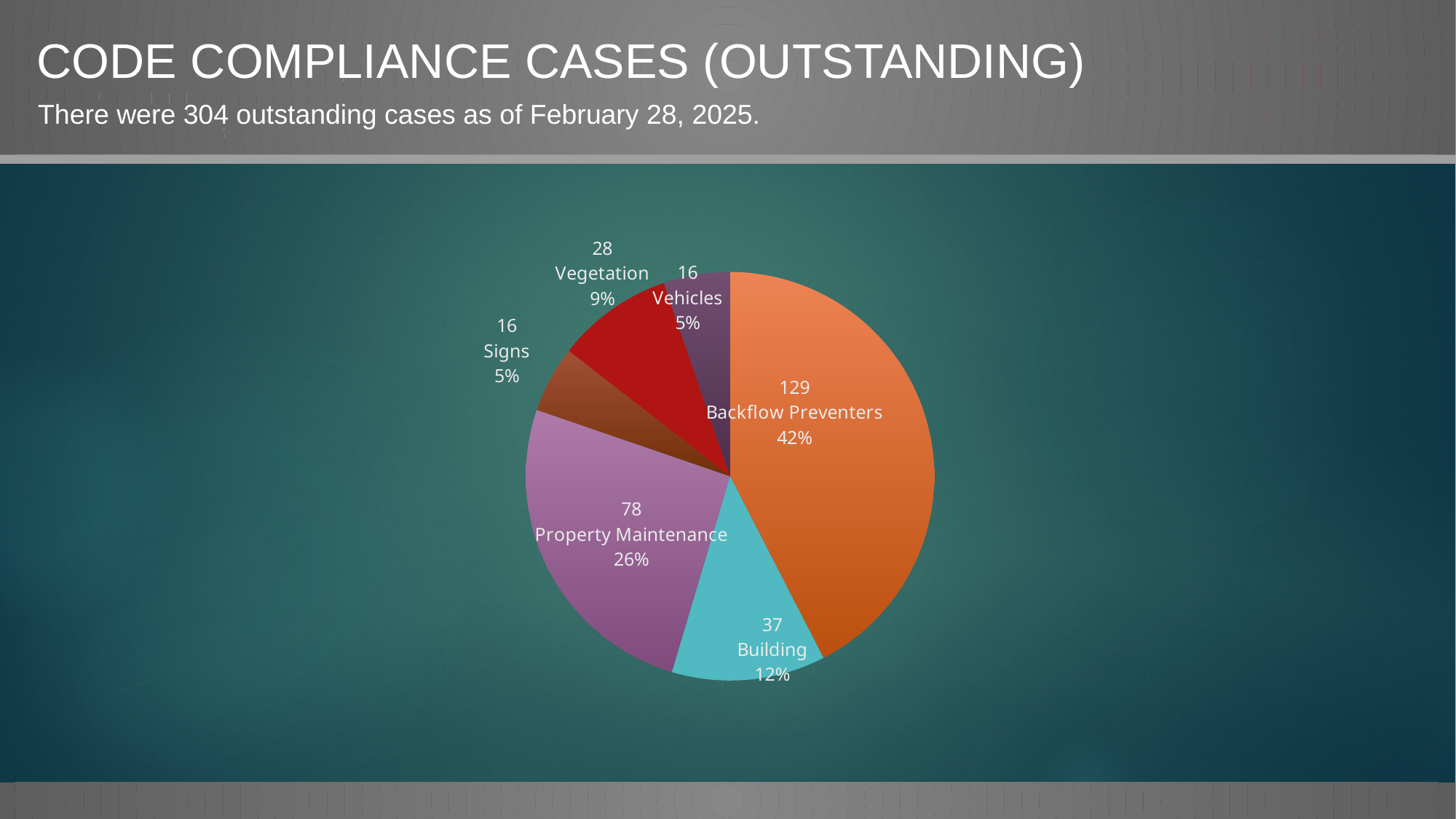
How many outstanding cases are there for Building? 37 How many outstanding cases are there for Property Maintenance? 78 Which has more outstanding cases, Building or Vegetation? Building What kind of chart is shown on the slide? Pie chart How many outstanding cases are there for Vegetation? 28 What percentage of outstanding cases does Property Maintenance represent? 26% How many outstanding cases are there for Backflow Preventers? 129 Which category has the largest share of outstanding cases? Backflow Preventers What percentage of outstanding cases does Building represent? 12% How many categories are shown in the pie chart? 6 What is the difference in outstanding cases between Backflow Preventers and Property Maintenance? 51 What is the title of the slide containing the chart? CODE COMPLIANCE CASES (OUTSTANDING)